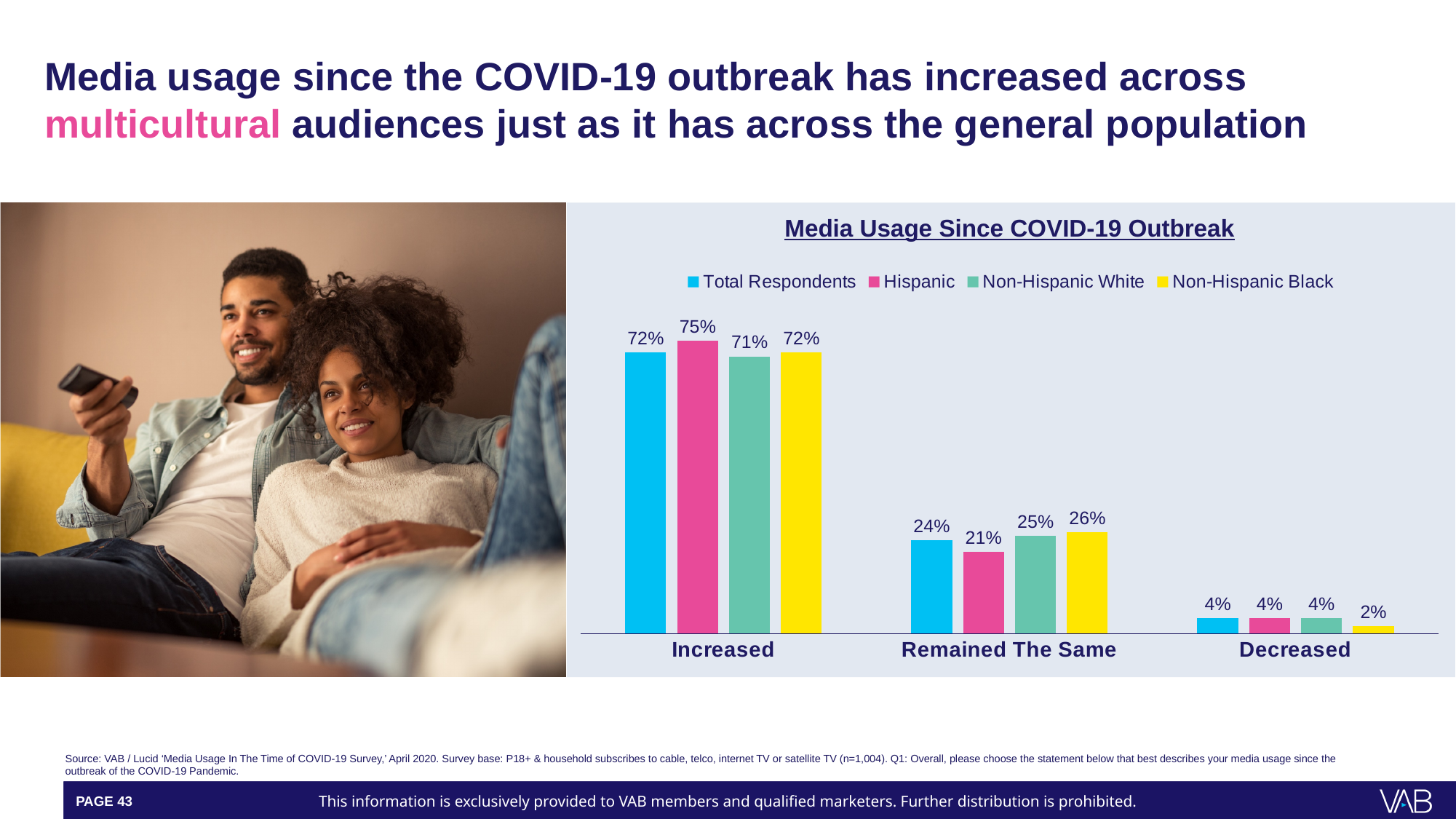
Do the values for Total Respondents rise or fall from Increased to Decreased along the x axis? fall What percentage of Hispanic respondents said their media usage increased? 75% How many categories are shown on the x axis? 3 What is the title of the chart? Media Usage Since COVID-19 Outbreak What kind of chart is shown on the slide? bar chart Which series has the lowest value in the Remained The Same category? Hispanic How many series does the legend list? 4 What percentage of Total Respondents said their media usage decreased? 4% What percentage of Non-Hispanic Black respondents said their media usage remained the same? 26% Which series has the highest value in the Increased category? Hispanic What is the difference between the Hispanic and Non-Hispanic White values in the Increased category? 4% In the Remained The Same category, is the value for Non-Hispanic White larger or smaller than the value for Hispanic? larger